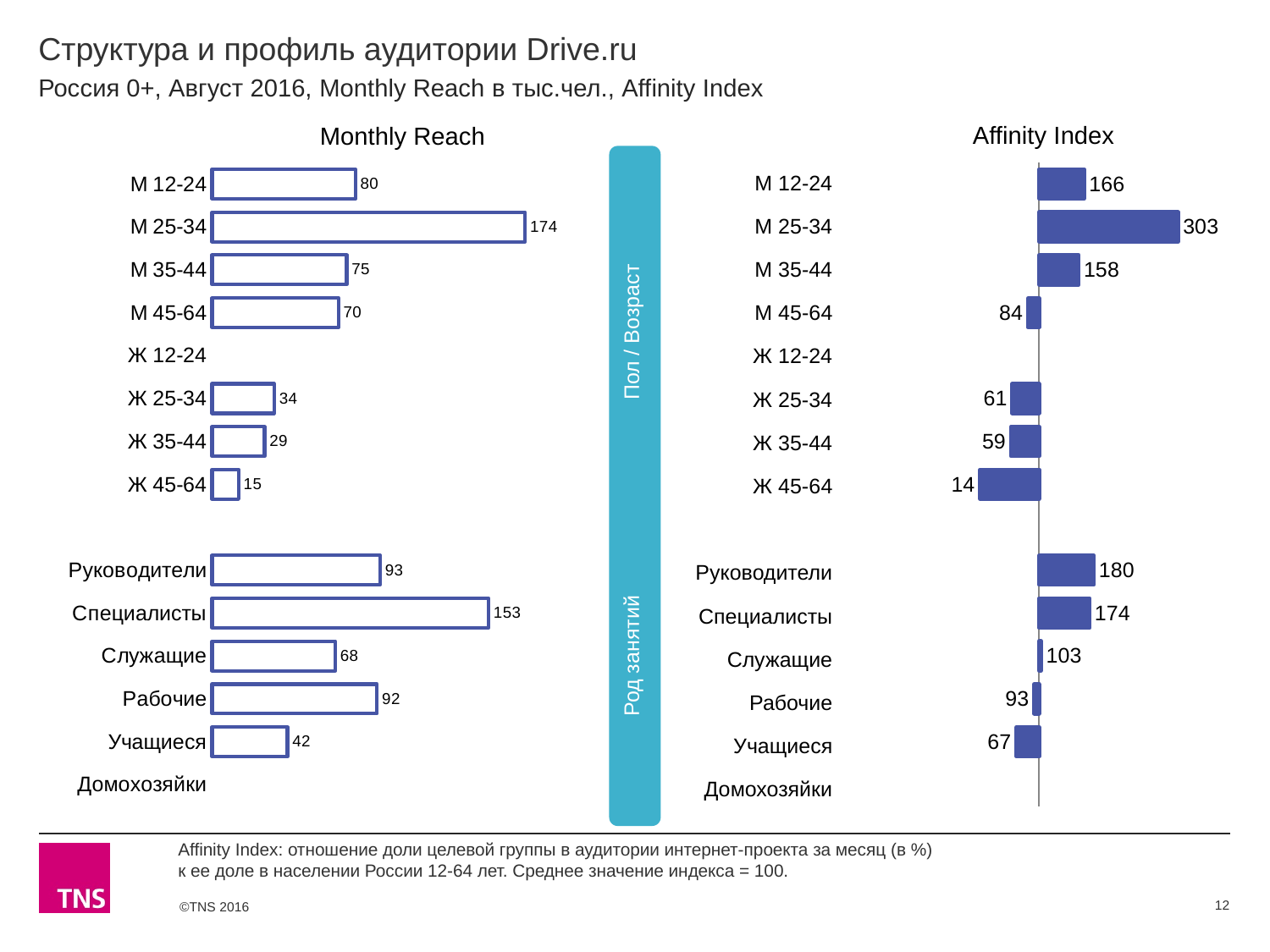
In the Monthly Reach chart, which category has the highest value? М 25-34 In the Monthly Reach chart, what is the value for М 25-34? 174 In the Affinity Index chart, what is the value for Ж 35-44? 59 In the Monthly Reach chart, what is the difference between Специалисты and Руководители? 60 In the Monthly Reach chart, what is the value for Учащиеся? 42 In the Monthly Reach chart, which is larger: Рабочие or Служащие? Рабочие In the Affinity Index chart, which category has the lowest value among those with a printed value? Ж 45-64 In the Affinity Index chart, what is the value for Руководители? 180 What type of chart is the Monthly Reach chart? Bar chart What is the title of the chart on the right side of the slide? Affinity Index In the Affinity Index chart, what is the difference between М 25-34 and М 12-24? 137 In the Affinity Index chart, which is larger: Ж 25-34 or Учащиеся? Учащиеся